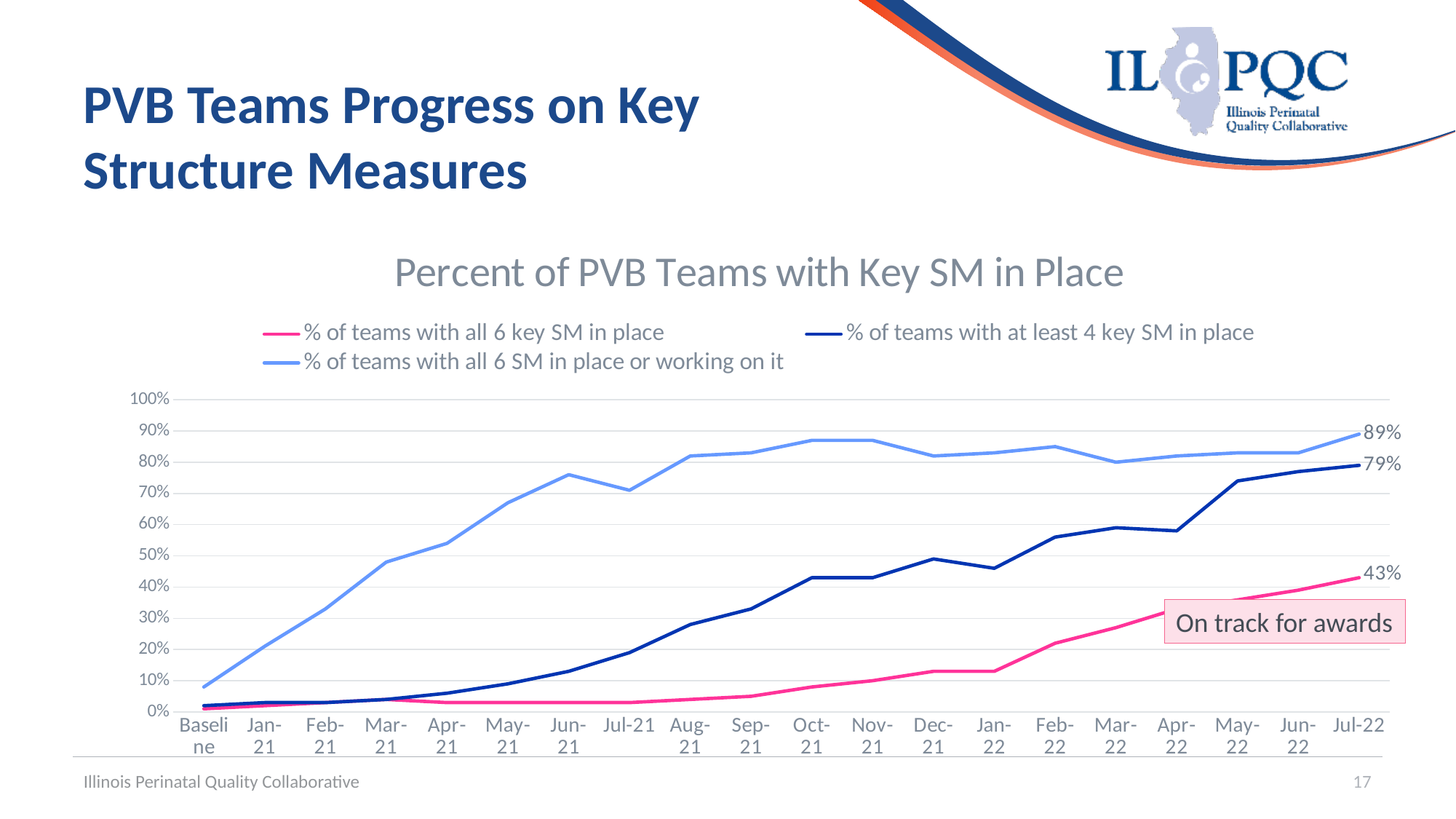
At Jul-22, what is the difference between '% of teams with all 6 SM in place or working on it' and '% of teams with at least 4 key SM in place'? 10 percentage points What is the value for '% of teams with all 6 SM in place or working on it' at Jul-22? 89% Is the value for '% of teams with all 6 key SM in place' at Dec-21 greater or less than 20%? less How many time points are plotted along the x axis? 20 How many series does the legend list? 3 At Jul-22, what is the difference between '% of teams with at least 4 key SM in place' and '% of teams with all 6 key SM in place'? 36 percentage points What type of chart is shown on the slide? line chart What is the value for '% of teams with at least 4 key SM in place' at Jul-22? 79% Which series has the highest value at Jul-22? % of teams with all 6 SM in place or working on it Overall, do the values for '% of teams with at least 4 key SM in place' rise or fall from Baseline to Jul-22? rise What is the value for '% of teams with all 6 key SM in place' at Jul-22? 43% Is the value for '% of teams with all 6 SM in place or working on it' at Oct-21 greater or less than 80%? greater